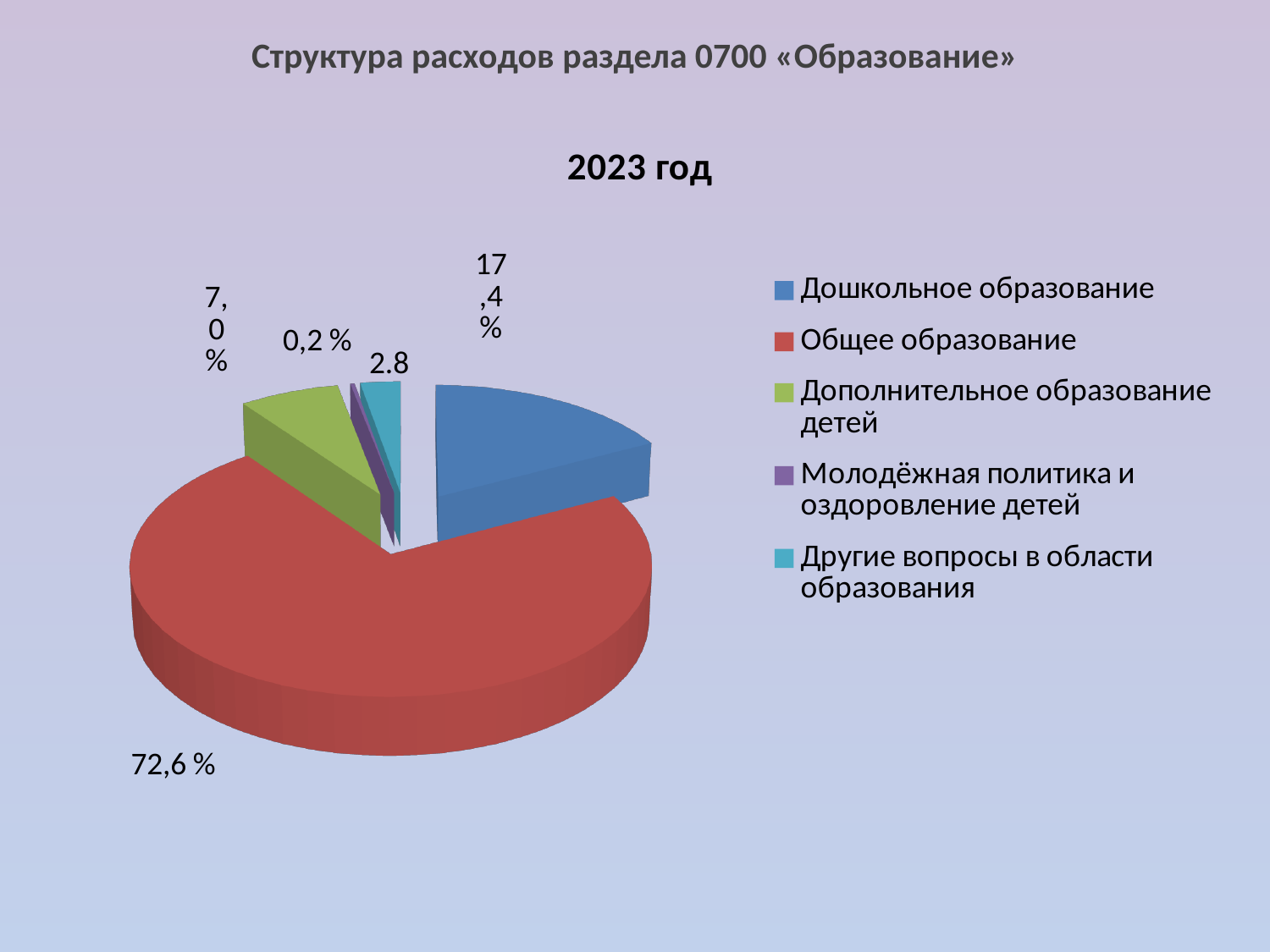
What share of expenditure is labelled for Общее образование? 72,6 % What share of expenditure is labelled for Дошкольное образование? 17,4 % How many categories does the legend list? 5 What year is shown in the chart title? 2023 год What share of expenditure is labelled for Молодёжная политика и оздоровление детей? 0,2 % Which is larger, the share for Дошкольное образование or the share for Дополнительное образование детей? Дошкольное образование Which category has the smallest slice of the pie? Молодёжная политика и оздоровление детей What is the difference in percentage points between Общее образование and Дошкольное образование? 55,2 What value is labelled for Другие вопросы в области образования? 2.8 What kind of chart is shown on the slide? pie chart Which category has the largest slice of the pie? Общее образование What share of expenditure is labelled for Дополнительное образование детей? 7,0 %